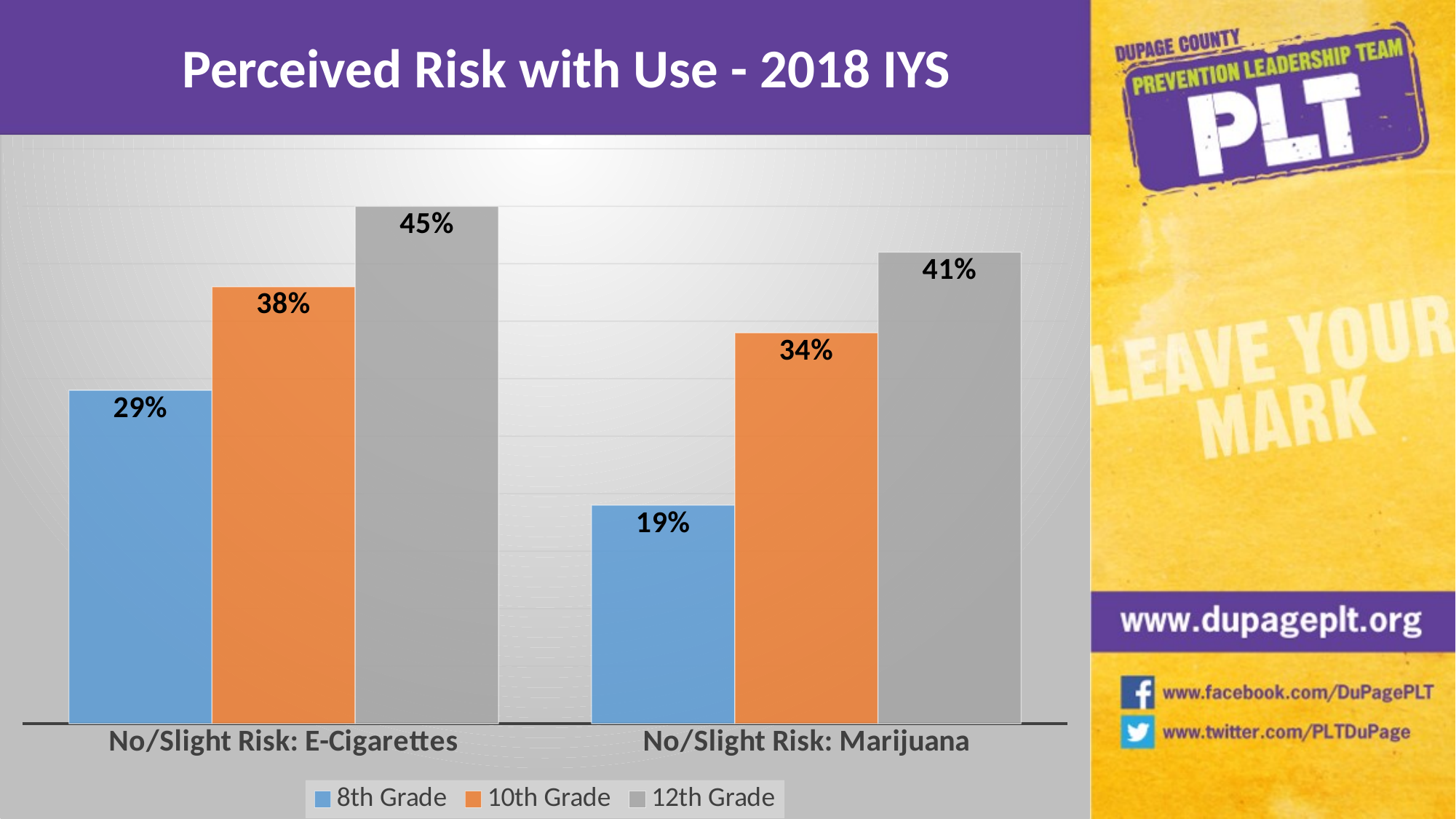
What is the value for 8th Grade in the No/Slight Risk: E-Cigarettes category? 29% What is the value for 12th Grade in the No/Slight Risk: Marijuana category? 41% Which grade has the highest value in the No/Slight Risk: E-Cigarettes category? 12th Grade What is the title of the chart? Perceived Risk with Use - 2018 IYS How many series does the legend list? 3 What is the difference between the 10th Grade values for No/Slight Risk: E-Cigarettes and No/Slight Risk: Marijuana? 4% How many categories are shown on the x axis? 2 What kind of chart is shown on the slide? Bar chart Which grade has the lowest value in the No/Slight Risk: Marijuana category? 8th Grade Which is larger: the 8th Grade value for No/Slight Risk: E-Cigarettes or the 8th Grade value for No/Slight Risk: Marijuana? No/Slight Risk: E-Cigarettes What is the value for 10th Grade in the No/Slight Risk: Marijuana category? 34% What is the difference between the 12th Grade and 8th Grade values for No/Slight Risk: E-Cigarettes? 16%